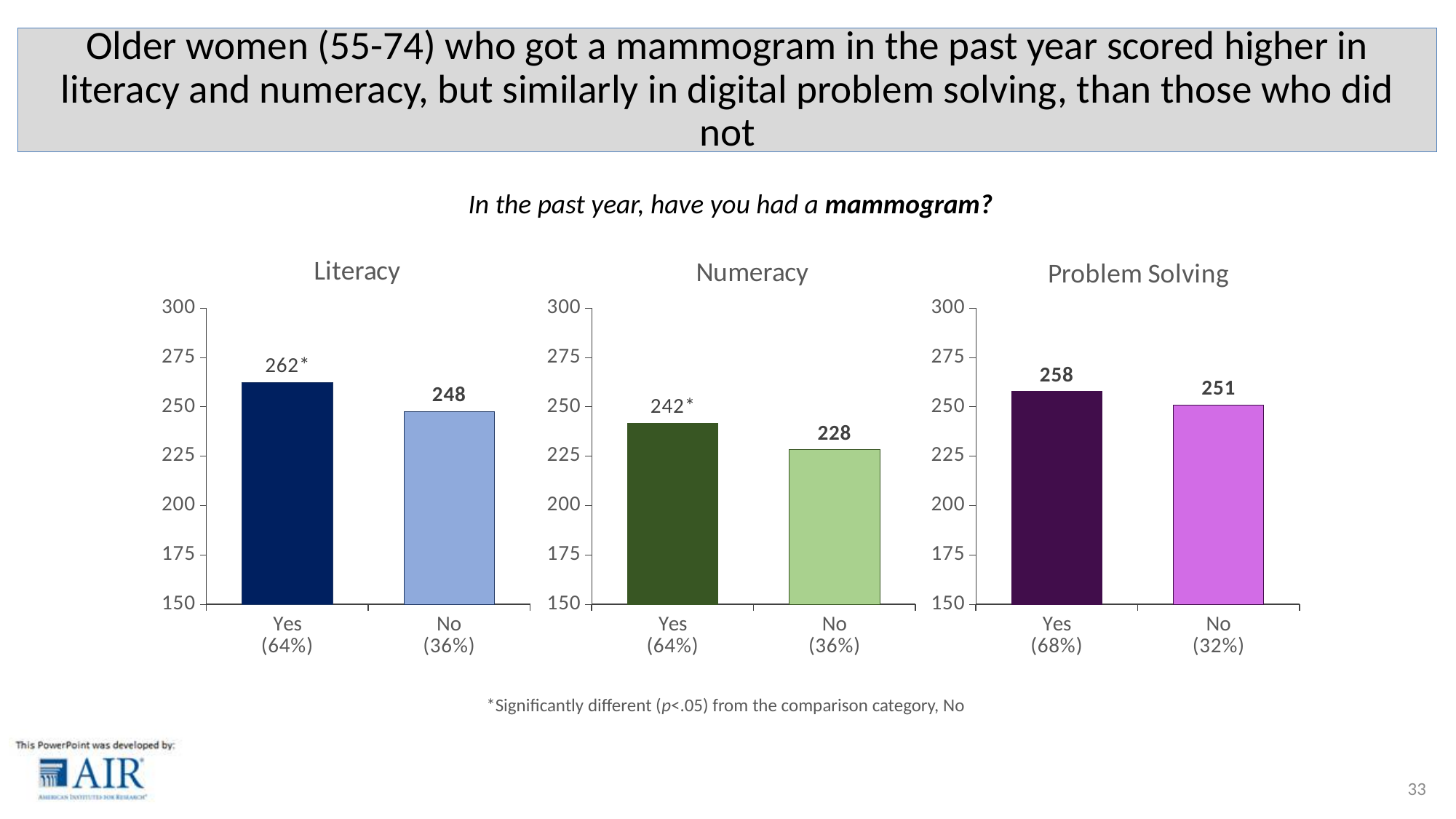
In the Problem Solving chart, which category has the higher value, Yes or No? Yes In the Literacy chart, what is the value for No (36%)? 248 In the Numeracy chart, what is the value for Yes (64%)? 242 What kind of chart is the Numeracy chart? Bar chart In the Numeracy chart, which category has the lowest value? No (36%) In the Literacy chart, what is the value for Yes (64%)? 262 How many categories are shown in the Literacy chart? 2 In the Numeracy chart, what is the difference between the Yes and No values? 14 In the Literacy chart, what is the difference between the Yes and No values? 14 In the Problem Solving chart, what is the value for Yes (68%)? 258 In the Problem Solving chart, what is the value for No (32%)? 251 In the Numeracy chart, what is the value for No (36%)? 228